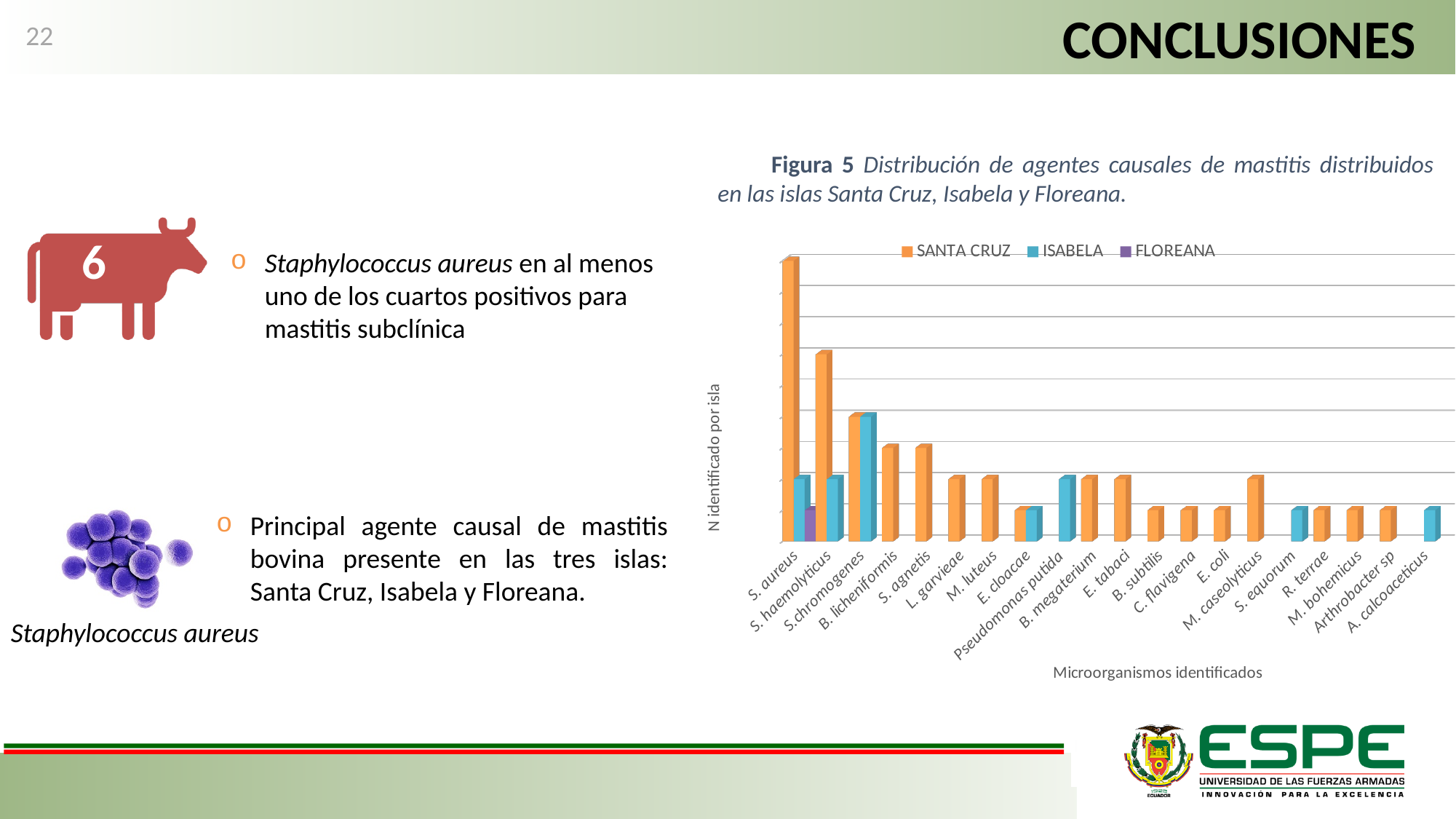
What is the title of the y axis of the chart? N identificado por isla Do the SANTA CRUZ values generally rise or fall from left to right along the x axis? fall How many series does the legend of the chart list? 3 Which microorganism has the tallest ISABELA bar in the chart? S.chromogenes Which microorganism has the highest SANTA CRUZ value in the chart? S. aureus Which is the only microorganism with a FLOREANA bar in the chart? S. aureus For SANTA CRUZ, which is larger: the value for S.chromogenes or the value for B. licheniformis? S.chromogenes For SANTA CRUZ, which is larger: the value for S. aureus or the value for S. haemolyticus? S. aureus Which series is shown in orange in the chart? SANTA CRUZ What kind of chart is shown in Figura 5? bar chart How many microorganisms are listed along the x axis of the chart? 20